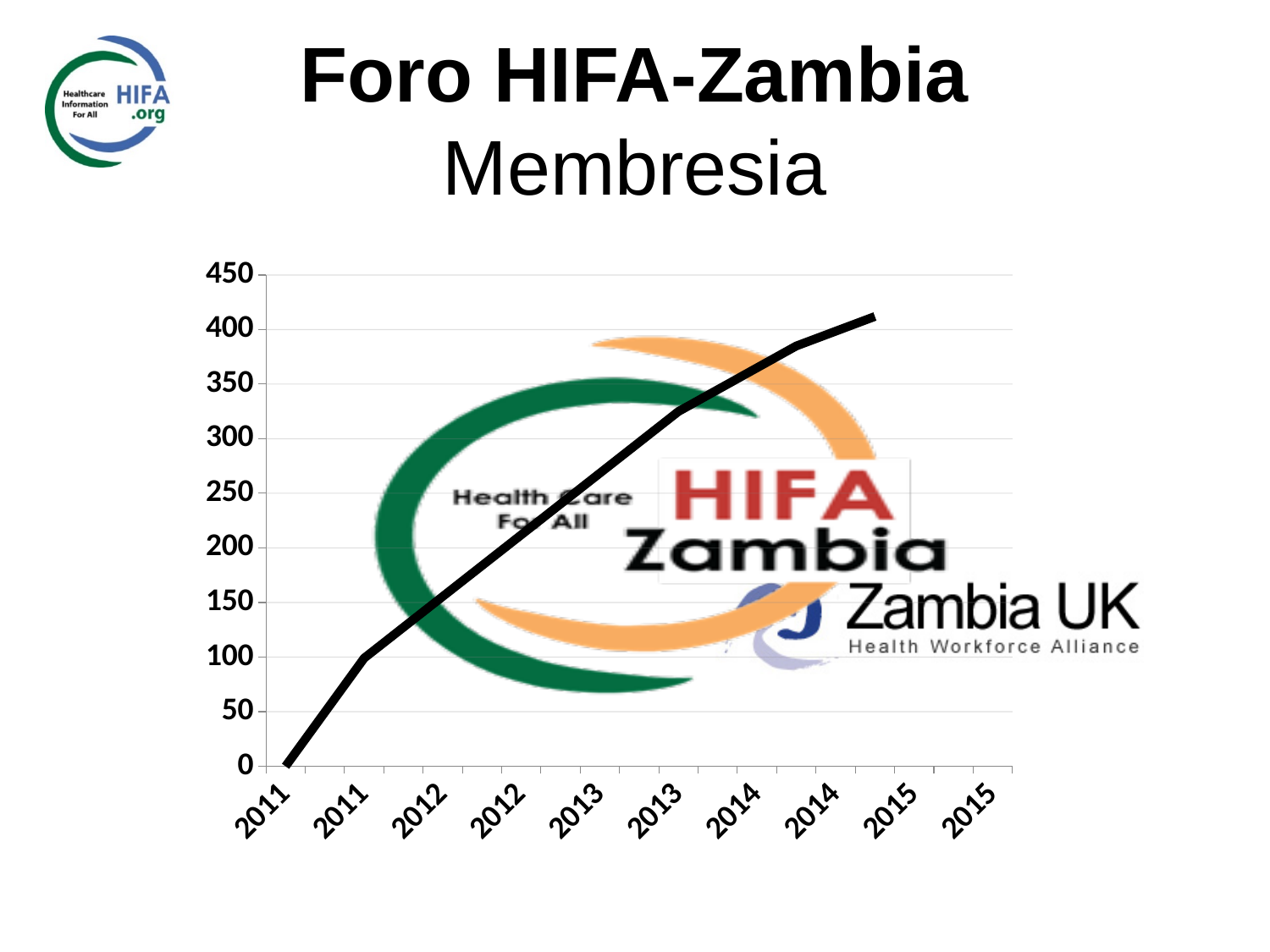
What is the value at the first 2011 point on the chart? 0 How many category labels are shown along the x axis of the chart? 10 Is the value at the first 2013 point greater or less than 200? greater Do the values on the chart rise or fall from left to right along the x axis? rise What is the highest tick value shown on the y axis of the chart? 450 Is the value at the second 2013 point greater or less than 250? greater What kind of chart is shown on the slide? line chart Which year has the highest value on the chart? 2015 Is the value at the first 2012 point greater or less than 100? greater Which year has the lowest value on the chart? 2011